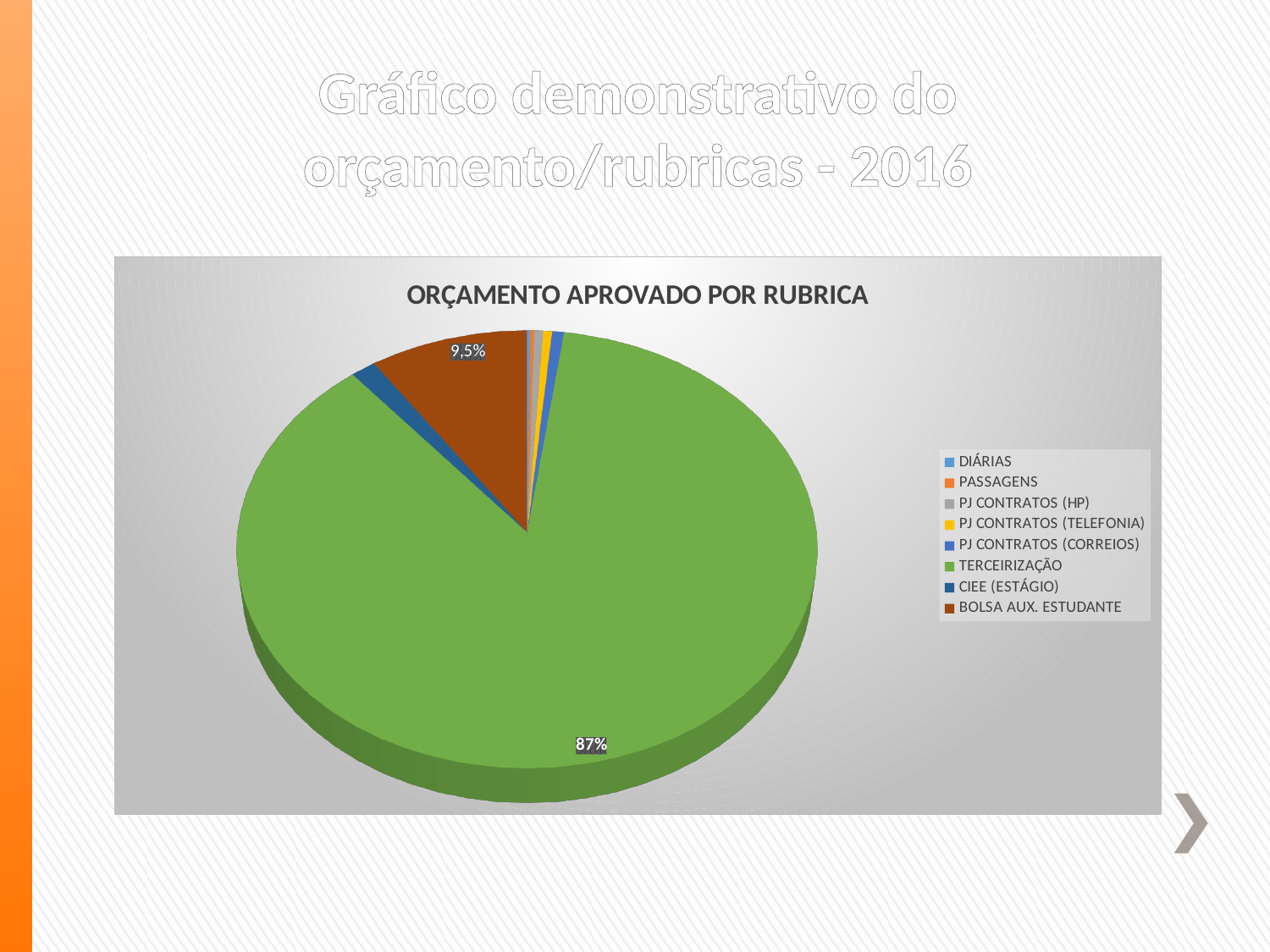
What kind of chart is shown on the slide? Pie chart Is the share for TERCEIRIZAÇÃO greater or less than 50%? greater What share of the pie does TERCEIRIZAÇÃO represent? 87% Which is larger, the slice for BOLSA AUX. ESTUDANTE or the slice for CIEE (ESTÁGIO)? BOLSA AUX. ESTUDANTE What is the difference in percentage points between the TERCEIRIZAÇÃO slice and the BOLSA AUX. ESTUDANTE slice? 77,5 What share of the pie does BOLSA AUX. ESTUDANTE represent? 9,5% Which is larger, the slice for TERCEIRIZAÇÃO or the slice for BOLSA AUX. ESTUDANTE? TERCEIRIZAÇÃO What is the title of the chart? ORÇAMENTO APROVADO POR RUBRICA Which category has the largest slice of the pie? TERCEIRIZAÇÃO Is the share for BOLSA AUX. ESTUDANTE greater or less than 20%? less What colour is the TERCEIRIZAÇÃO slice in the pie chart? Green How many categories does the legend of the pie chart list? 8